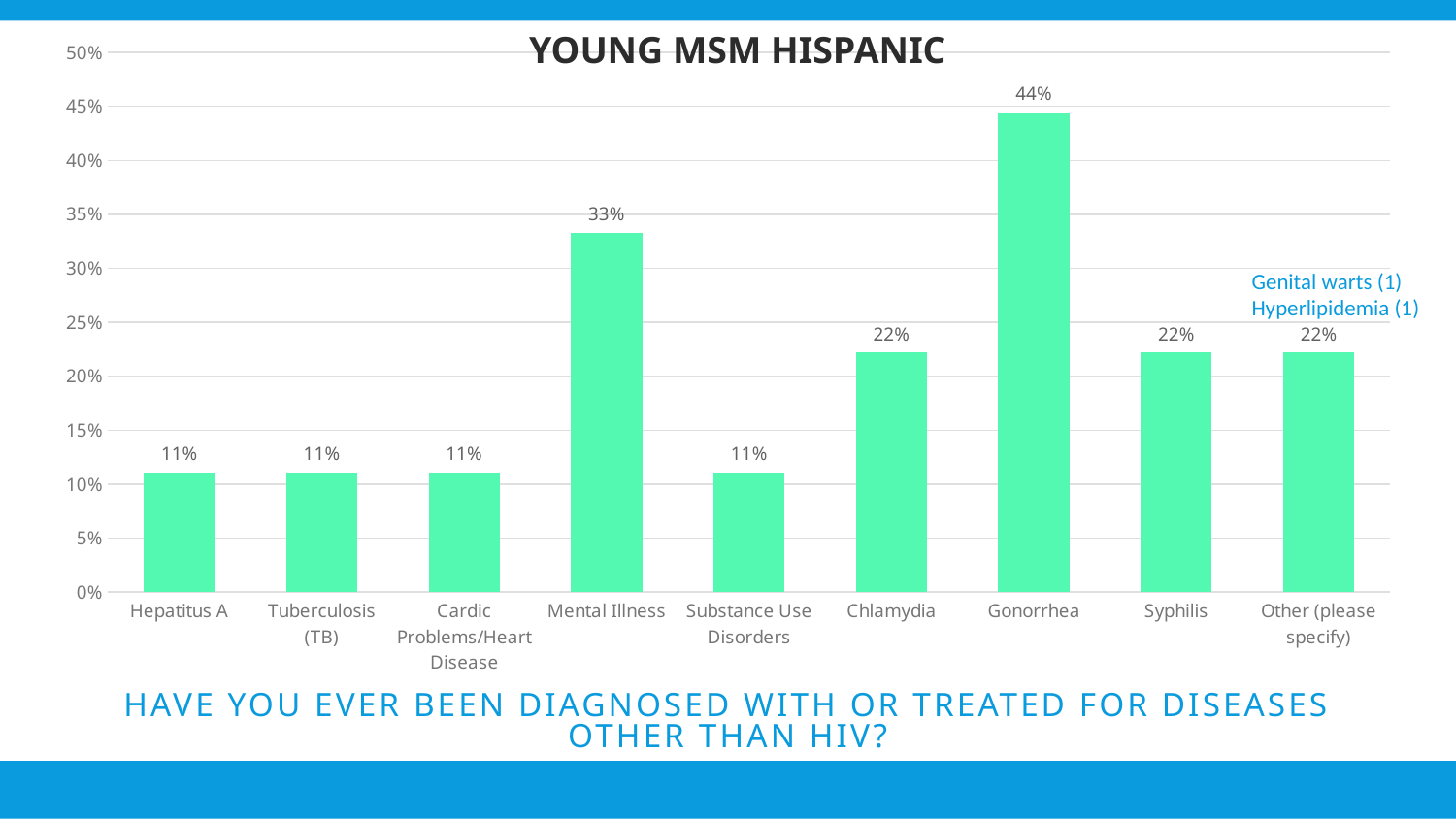
What is the difference between the values for Syphilis and Substance Use Disorders? 11% What is the title of the chart? YOUNG MSM HISPANIC What is the value for Chlamydia? 22% What is the value for Gonorrhea? 44% What is the value for Hepatitus A? 11% Is the value for Gonorrhea greater or less than 40%? greater What is the difference between the values for Gonorrhea and Mental Illness? 11% What is the value for Mental Illness? 33% What kind of chart is shown on the slide? bar chart Which is larger, the value for Mental Illness or the value for Chlamydia? Mental Illness How many categories are shown on the x axis? 9 Which category has the highest value? Gonorrhea